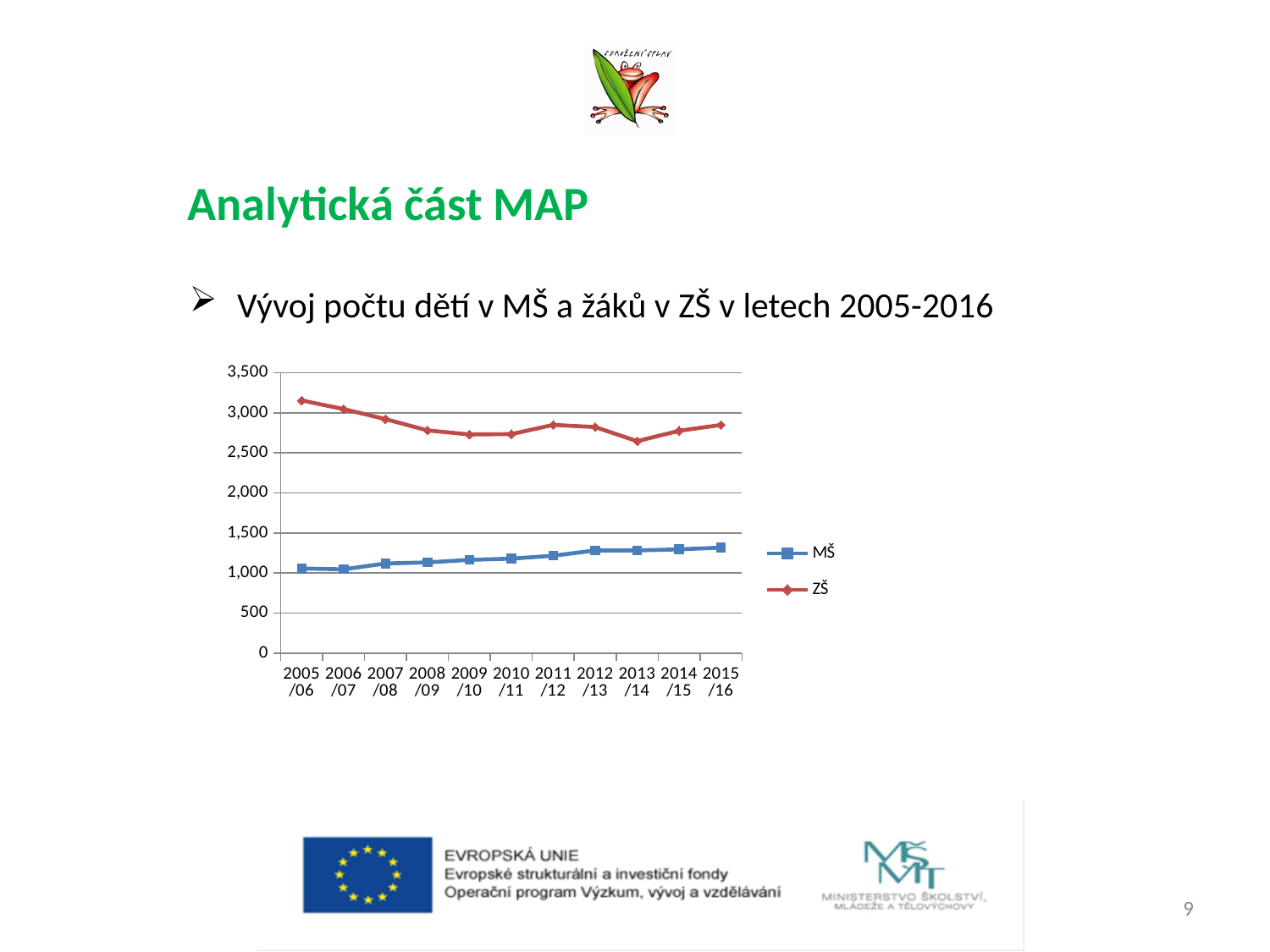
What kind of chart is shown on the slide? line chart Which series is shown in blue with square markers? MŠ In 2010/11, which series has the larger value, MŠ or ZŠ? ZŠ In which school year is the ZŠ value lowest? 2013/14 Is the ZŠ value for 2005/06 greater or less than 3,000? greater Does the MŠ series rise or fall from 2005/06 to 2015/16? rise Is the MŠ value for 2015/16 greater or less than 1,500? less In which school year is the ZŠ value highest? 2005/06 Which series is shown in red on the chart? ZŠ Does the ZŠ series rise or fall from 2005/06 to 2013/14? fall How many school years are plotted along the x axis of the chart? 11 How many series does the chart legend list? 2